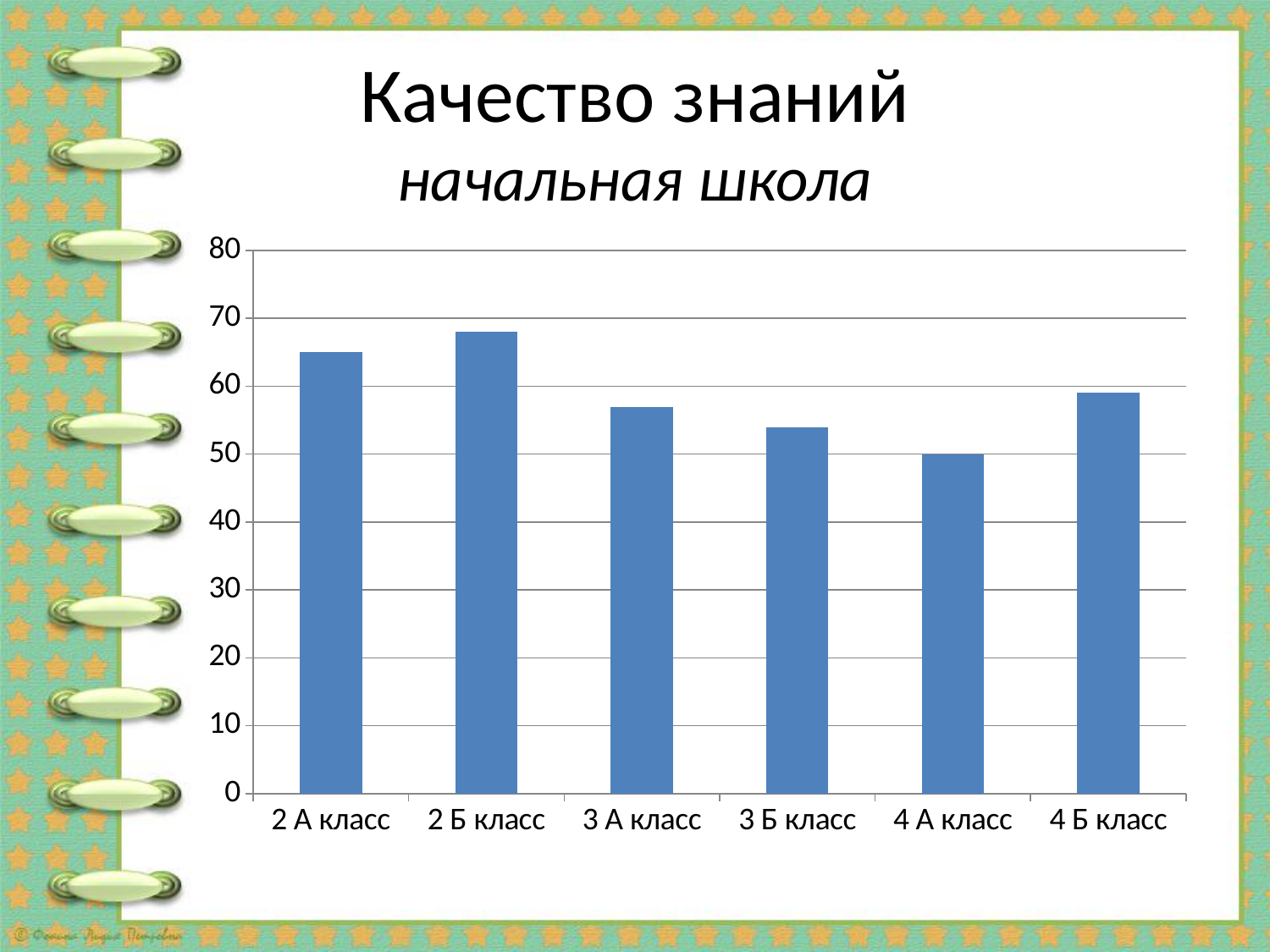
Is the value for 3 Б класс greater or less than 50? greater Which is larger, the value for 3 Б класс or the value for 4 Б класс? 4 Б класс Is the value for 3 А класс greater or less than 60? less What is the title of the slide containing the chart? Качество знаний начальная школа What kind of chart is shown on the slide? bar chart Is the value for 2 А класс greater or less than 60? greater Which is larger, the value for 2 А класс or the value for 3 А класс? 2 А класс Which class has the lowest bar in the chart? 4 А класс How many classes (categories) are shown on the x axis of the chart? 6 Which class has the highest bar in the chart? 2 Б класс